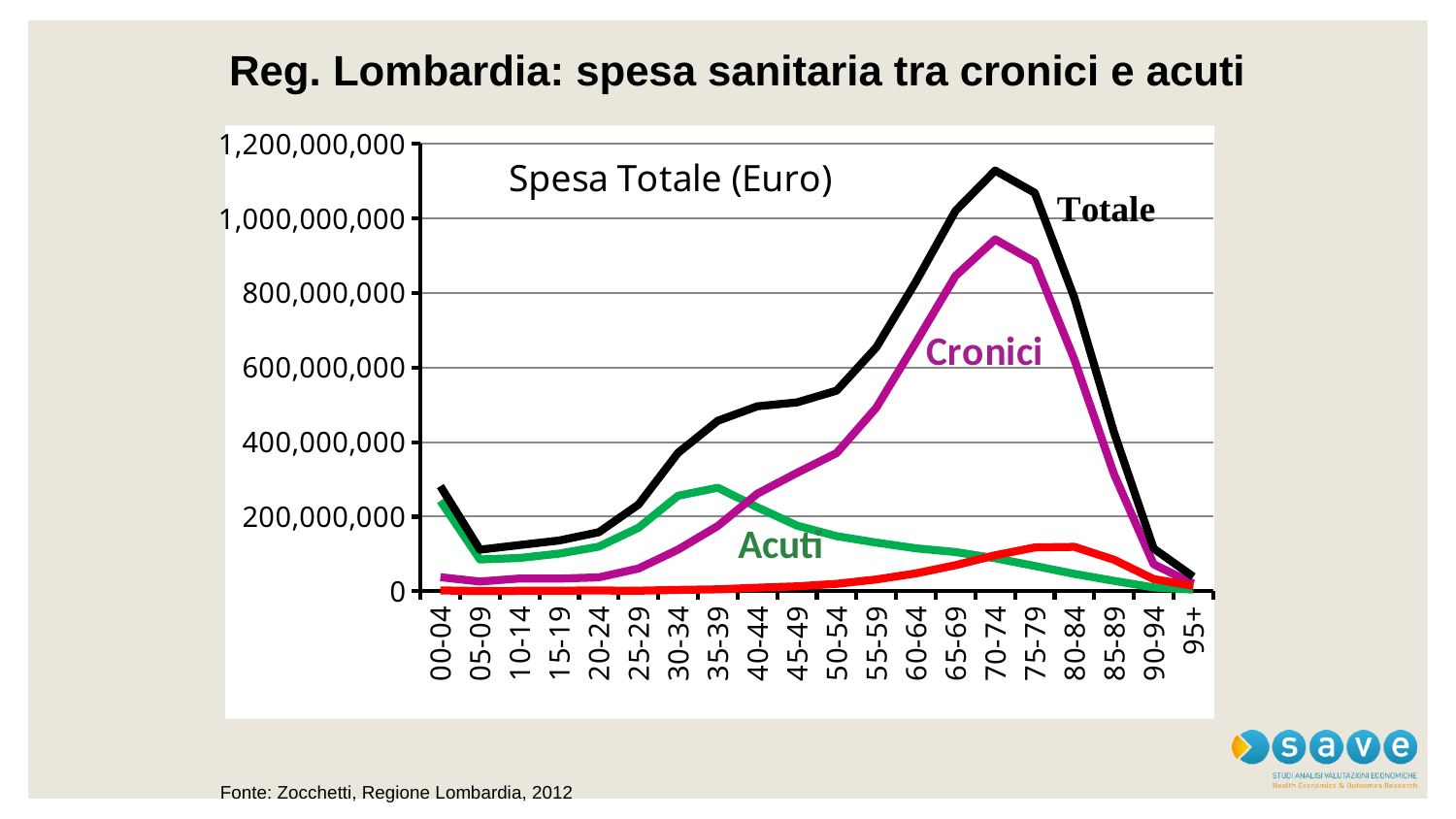
What is the title printed inside the chart area? Spesa Totale (Euro) Is the Totale value for 05-09 greater or less than 200,000,000? less Is the Totale value for 50-54 greater or less than 400,000,000? greater At 35-39, which is larger: Acuti or Cronici? Acuti Is the Totale value for 70-74 greater or less than 1,000,000,000? greater What kind of chart is shown on the slide? line chart How many age groups are shown on the x axis? 20 In which age group does the Cronici line reach its highest value? 70-74 Does the Cronici line rise or fall from 70-74 to 95+? fall In which age group does the Acuti line reach its highest value? 35-39 In which age group does the Totale line reach its highest value? 70-74